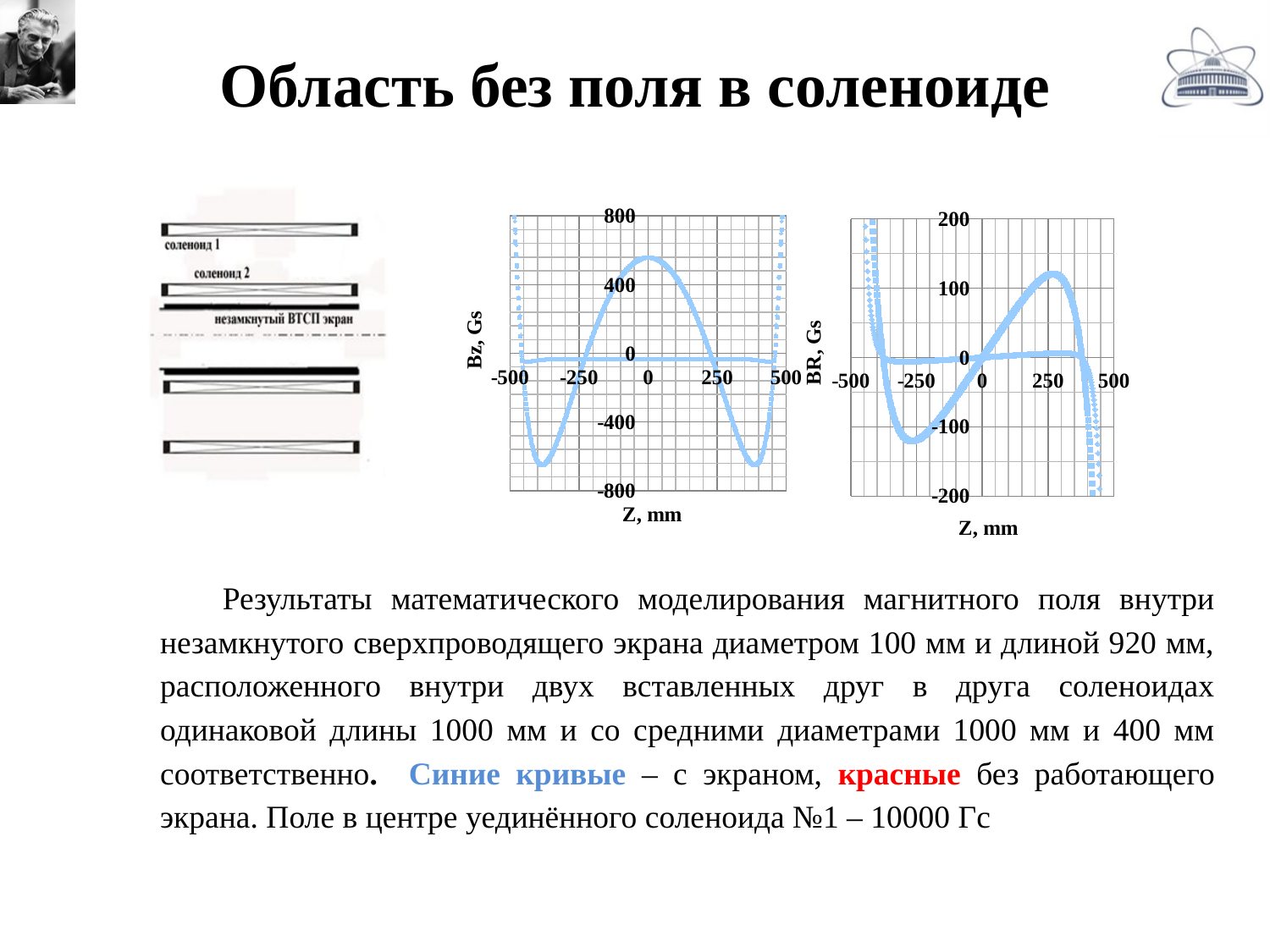
What is the maximum value shown on the vertical axis of the right chart (BR, Gs)? 200 What is the label of the vertical axis on the left chart? Bz, Gs On the left chart (Bz, Gs), does the curve rise or fall as Z goes from 0 mm to 400 mm? fall What kind of chart is the left chart (Bz, Gs vs Z, mm)? scatter (line) chart On the right chart (BR, Gs), is the value at Z = 250 mm greater or less than 200? less On the left chart (Bz, Gs), is the minimum value of the curve near Z = -400 mm greater or less than -400? less What is the label of the vertical axis on the right chart? BR, Gs On the left chart (Bz, Gs), does the curve rise or fall as Z goes from -400 mm to 0 mm? rise On the left chart (Bz, Gs), is the value at Z = 0 mm greater or less than 800? less